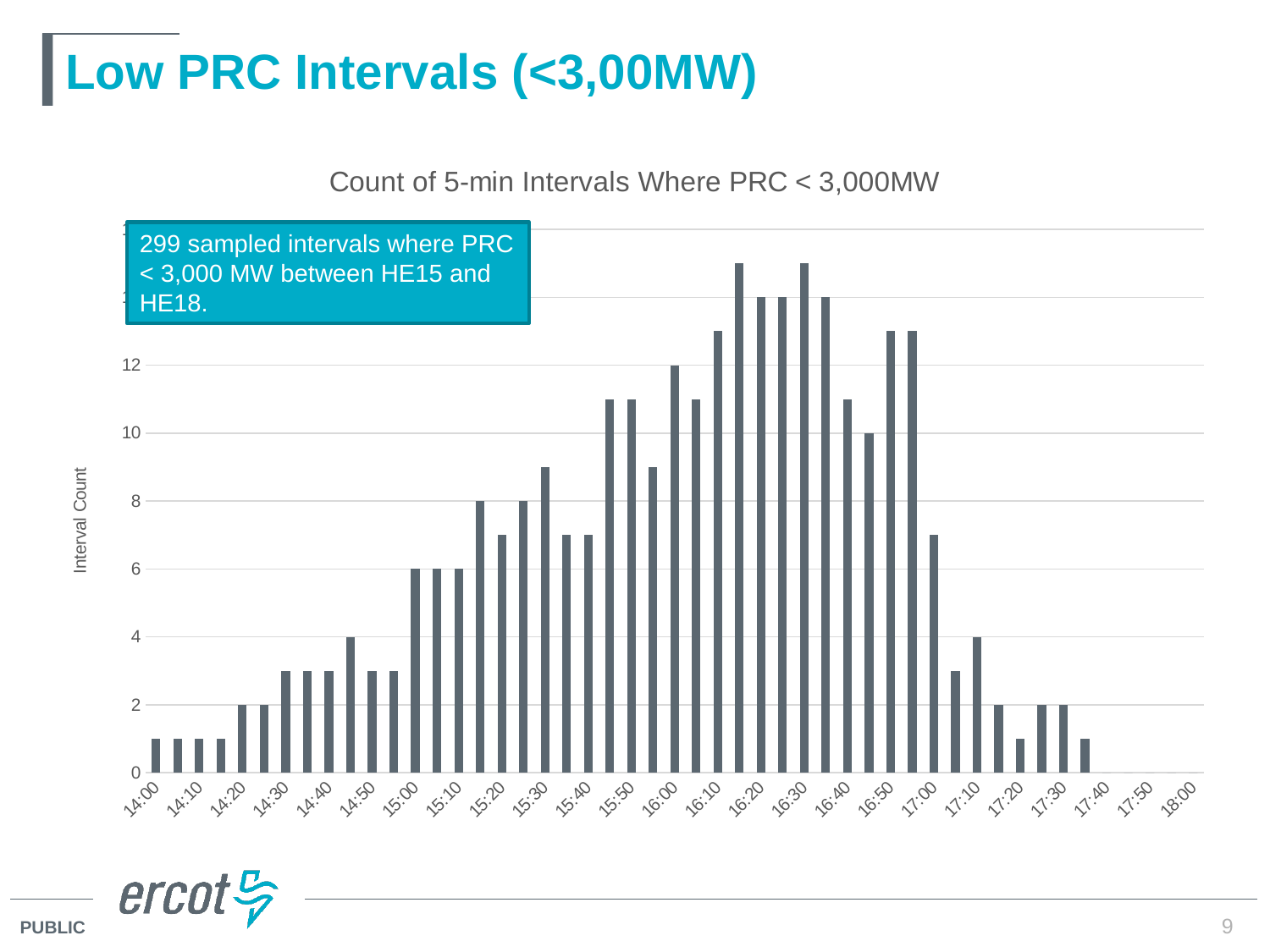
What is the title of the chart? Count of 5-min Intervals Where PRC < 3,000MW Which has a higher interval count, 15:00 or 16:50? 16:50 What is the label on the y axis of the chart? Interval Count Is the interval count at 16:30 greater or less than 12? greater What is the interval count at 14:20? 2 What is the interval count at 16:00? 12 What is the difference between the interval count at 16:00 and at 15:00? 6 What is the interval count at 15:00? 6 Do the interval counts generally rise or fall from 14:00 to 16:00? Rise What kind of chart is shown on the slide? Bar chart